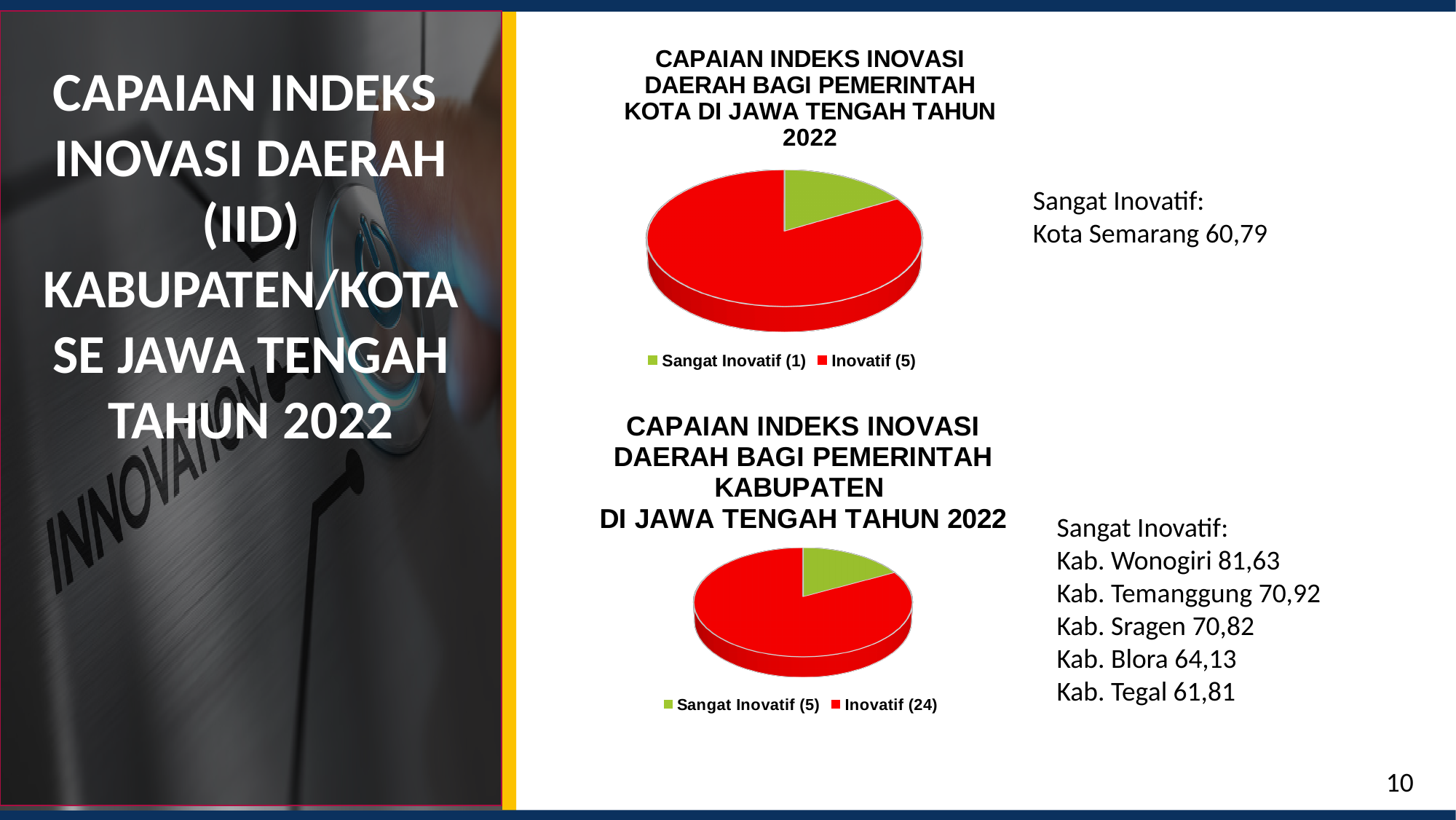
In the top chart (Pemerintah Kota), which is larger: the 'Sangat Inovatif' slice or the 'Inovatif' slice? Inovatif What type of chart is the top chart, 'Capaian Indeks Inovasi Daerah bagi Pemerintah Kota di Jawa Tengah Tahun 2022'? Pie chart In the bottom chart (Pemerintah Kabupaten), how many regencies are in the 'Inovatif' category? 24 In the bottom chart (Pemerintah Kabupaten), how many regencies are in the 'Sangat Inovatif' category? 5 What type of chart is the bottom chart, 'Capaian Indeks Inovasi Daerah bagi Pemerintah Kabupaten di Jawa Tengah Tahun 2022'? Pie chart In the bottom chart (Pemerintah Kabupaten), which category has the largest slice? Inovatif (24) In the top chart (Pemerintah Kota), what colour is the 'Inovatif' slice? Red In the top chart (Pemerintah Kota), which category has the smallest slice? Sangat Inovatif (1) In the top chart (Pemerintah Kota), how many cities are in the 'Inovatif' category? 5 In the bottom chart (Pemerintah Kabupaten), what is the difference between the number of 'Inovatif' and 'Sangat Inovatif' regencies? 19 How many slices does the bottom chart (Pemerintah Kabupaten) have? 2 In the top chart (Pemerintah Kota), how many cities are in the 'Sangat Inovatif' category? 1